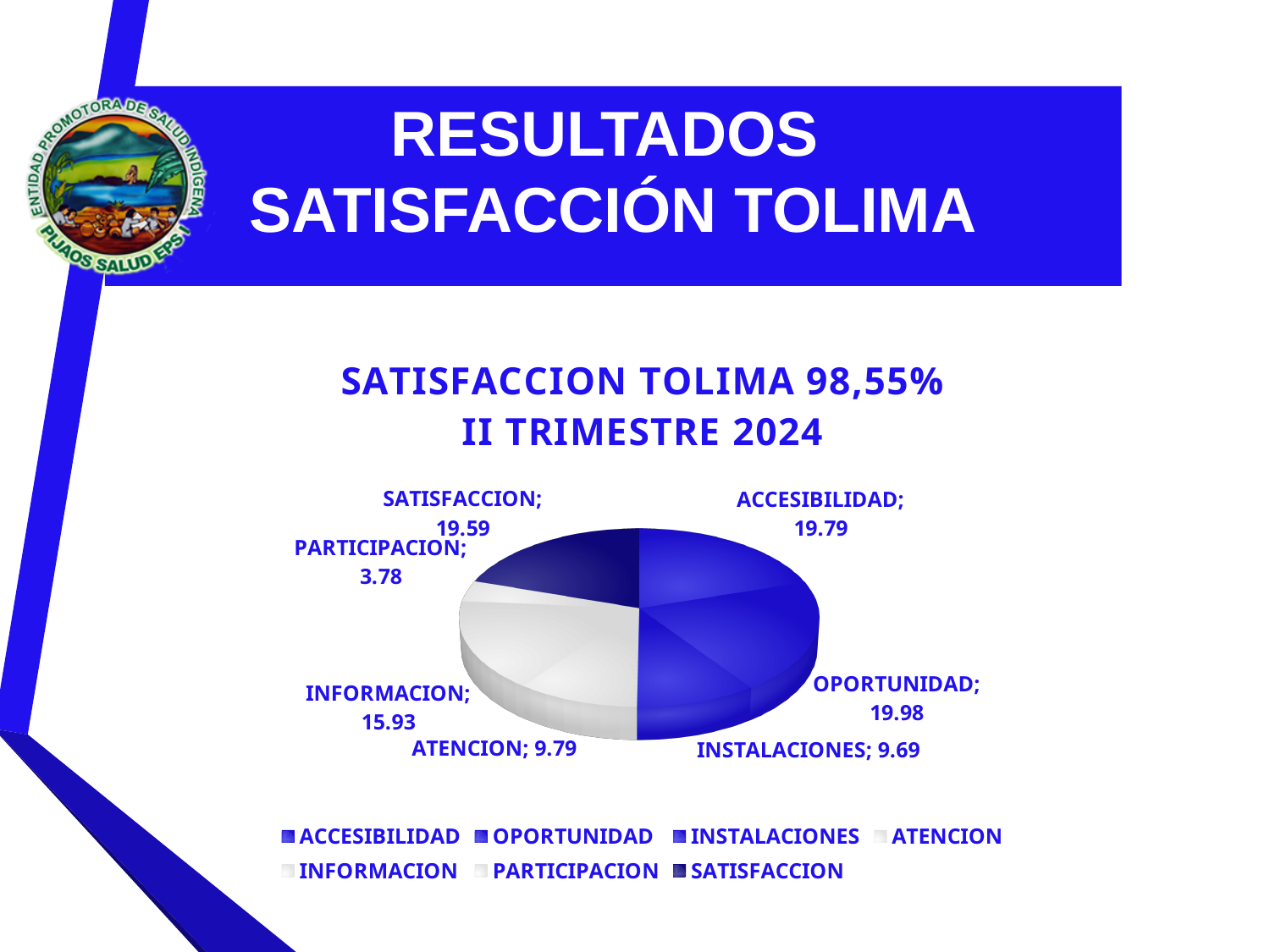
How many categories (slices) are shown in the pie chart? 7 What is the value shown for INSTALACIONES in the pie chart? 9.69 What is the difference between the values for ACCESIBILIDAD and INSTALACIONES? 10.1 Which category has the highest value in the pie chart? OPORTUNIDAD What is the value shown for PARTICIPACION in the pie chart? 3.78 Which has a larger value, ATENCION or INSTALACIONES? ATENCION Which category has the lowest value in the pie chart? PARTICIPACION What kind of chart is shown on the slide? Pie chart What is the title of the chart? SATISFACCION TOLIMA 98,55% II TRIMESTRE 2024 What is the difference between the values for SATISFACCION and PARTICIPACION? 15.81 What is the value shown for INFORMACION in the pie chart? 15.93 What is the value shown for OPORTUNIDAD in the pie chart? 19.98